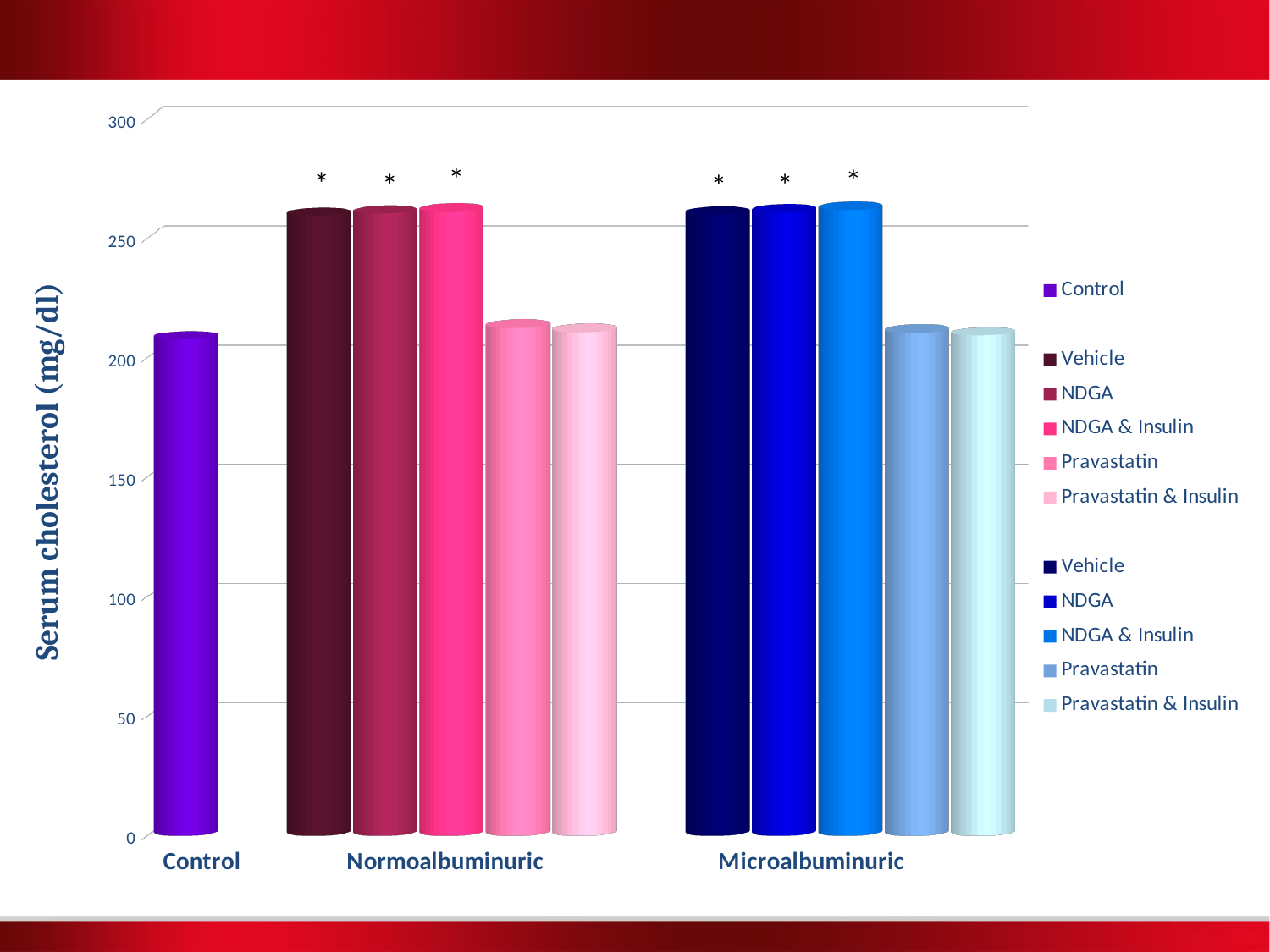
Which is larger in the Microalbuminuric group: NDGA or Pravastatin & Insulin? NDGA Is the value for Control greater or less than 200? greater Is the value for Pravastatin in the Normoalbuminuric group greater or less than 250? less How many bars are marked with an asterisk? 6 Is the value for NDGA & Insulin in the Microalbuminuric group greater or less than 250? greater Which is larger in the Normoalbuminuric group: Vehicle or Pravastatin? Vehicle How many series does the legend list? 11 How many categories are shown on the x axis? 3 What kind of chart is shown on the slide? bar chart What is the title of the y axis? Serum cholesterol (mg/dl)